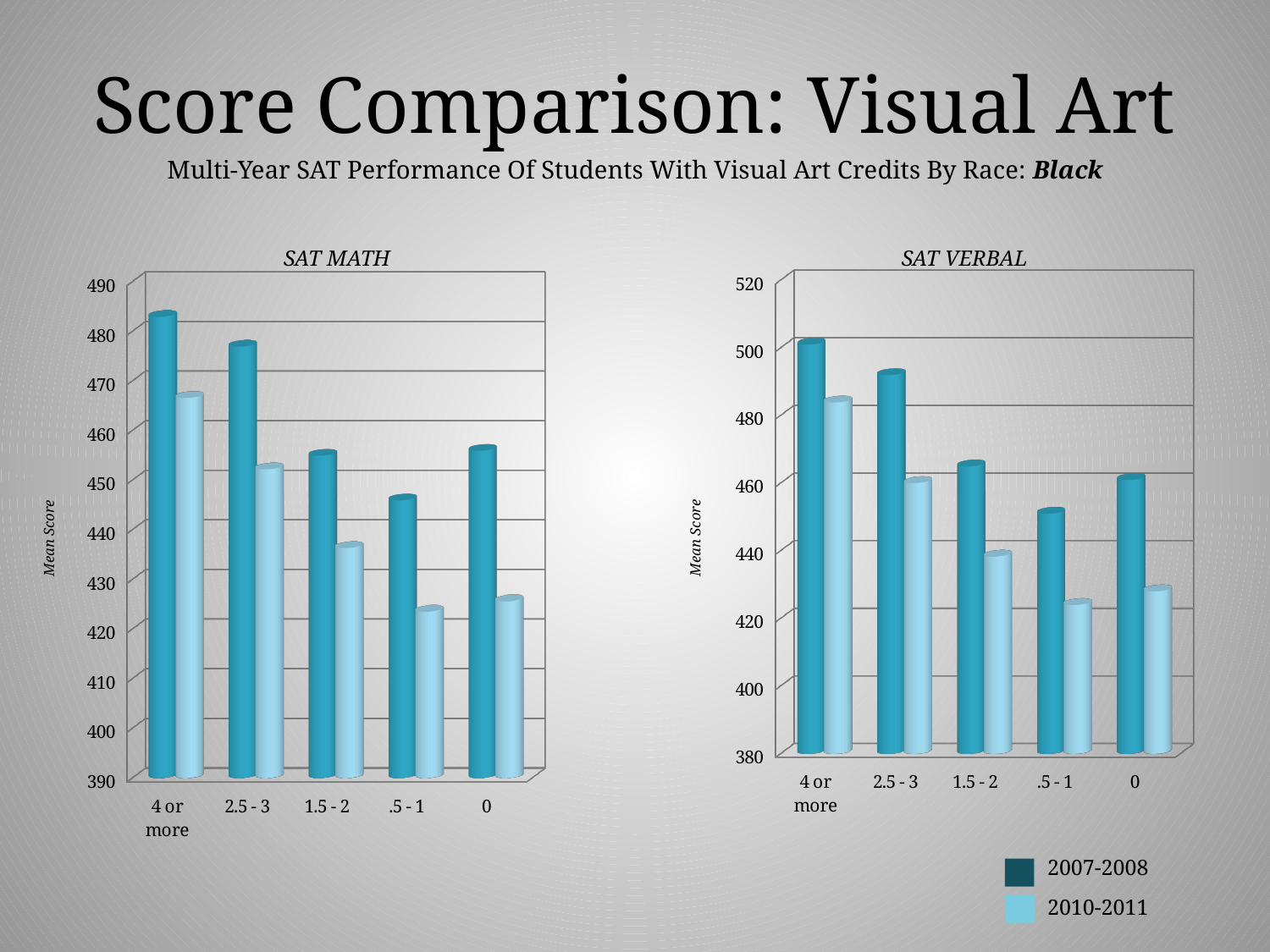
In the SAT MATH chart, is the 2007-2008 value for 4 or more greater or less than 470? greater In the SAT VERBAL chart, is the 2010-2011 value for 0 greater or less than 440? less In the SAT VERBAL chart, which category has the lowest 2007-2008 value? .5 - 1 How many series does the legend list for the charts? 2 In the SAT MATH chart, is the 2010-2011 value for .5 - 1 greater or less than 430? less What kind of chart is the SAT MATH chart? bar chart In the SAT VERBAL chart, do the 2010-2011 values rise or fall from 4 or more to .5 - 1? fall In the SAT VERBAL chart, for the 2010-2011 series, which is larger: 2.5 - 3 or 1.5 - 2? 2.5 - 3 In the SAT MATH chart, for the 2.5 - 3 category, which series has the larger value, 2007-2008 or 2010-2011? 2007-2008 What is the label on the vertical axis of the SAT MATH chart? Mean Score How many categories are shown on the x axis of the SAT VERBAL chart? 5 In the SAT MATH chart, which category has the highest 2007-2008 value? 4 or more